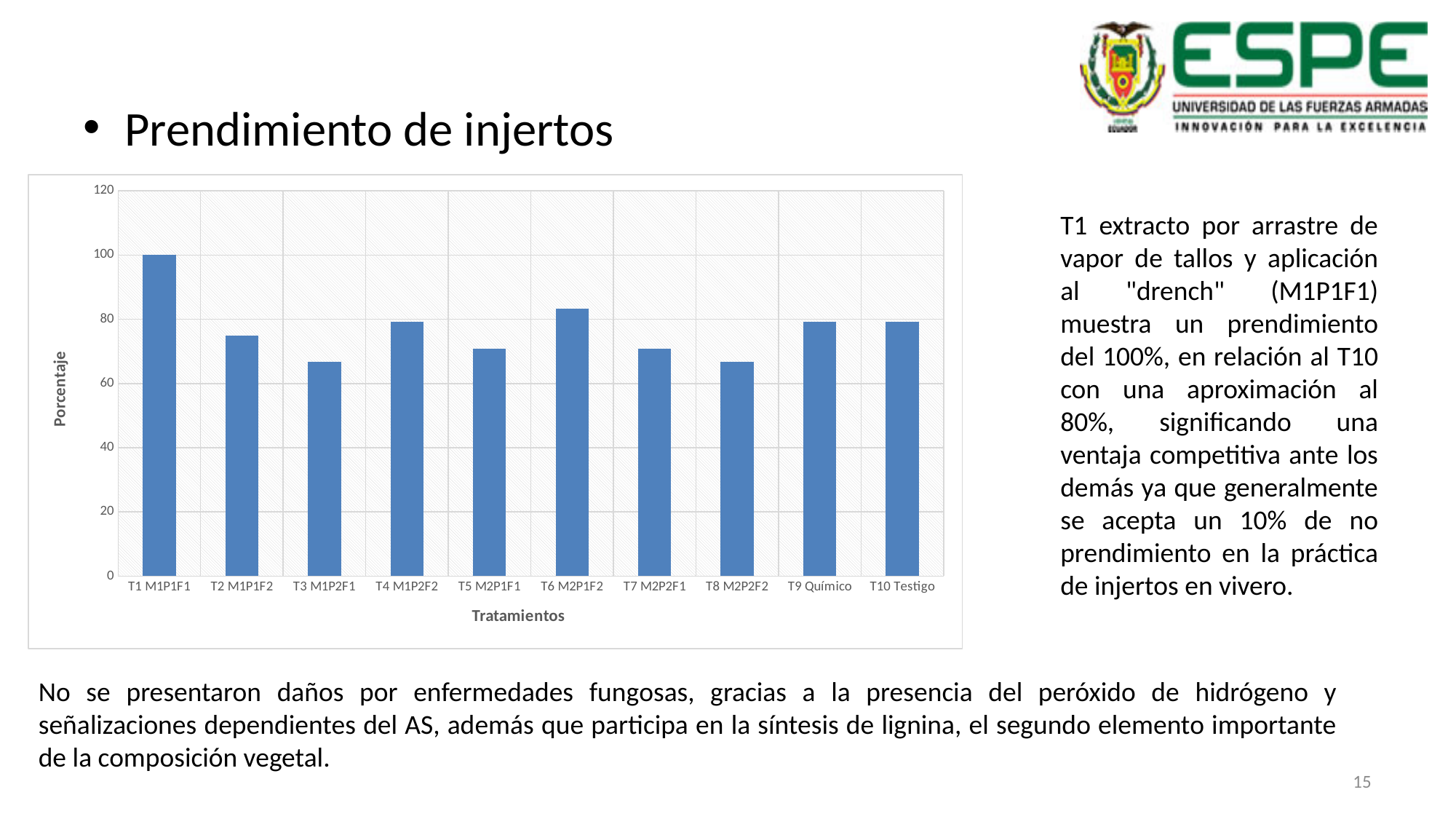
What is the value for T1 M1P1F1? 100 What type of chart is shown on the slide? bar chart Is the value for T5 M2P1F1 greater or less than 60? greater Which is larger, the value for T6 M2P1F2 or the value for T2 M1P1F2? T6 M2P1F2 Which is larger, the value for T1 M1P1F1 or the value for T10 Testigo? T1 M1P1F1 What is the title of the vertical axis? Porcentaje Is the value for T6 M2P1F2 greater or less than 80? greater Is the value for T3 M1P2F1 greater or less than 80? less Which treatment has the highest value? T1 M1P1F1 How many treatments (categories) are plotted on the x axis? 10